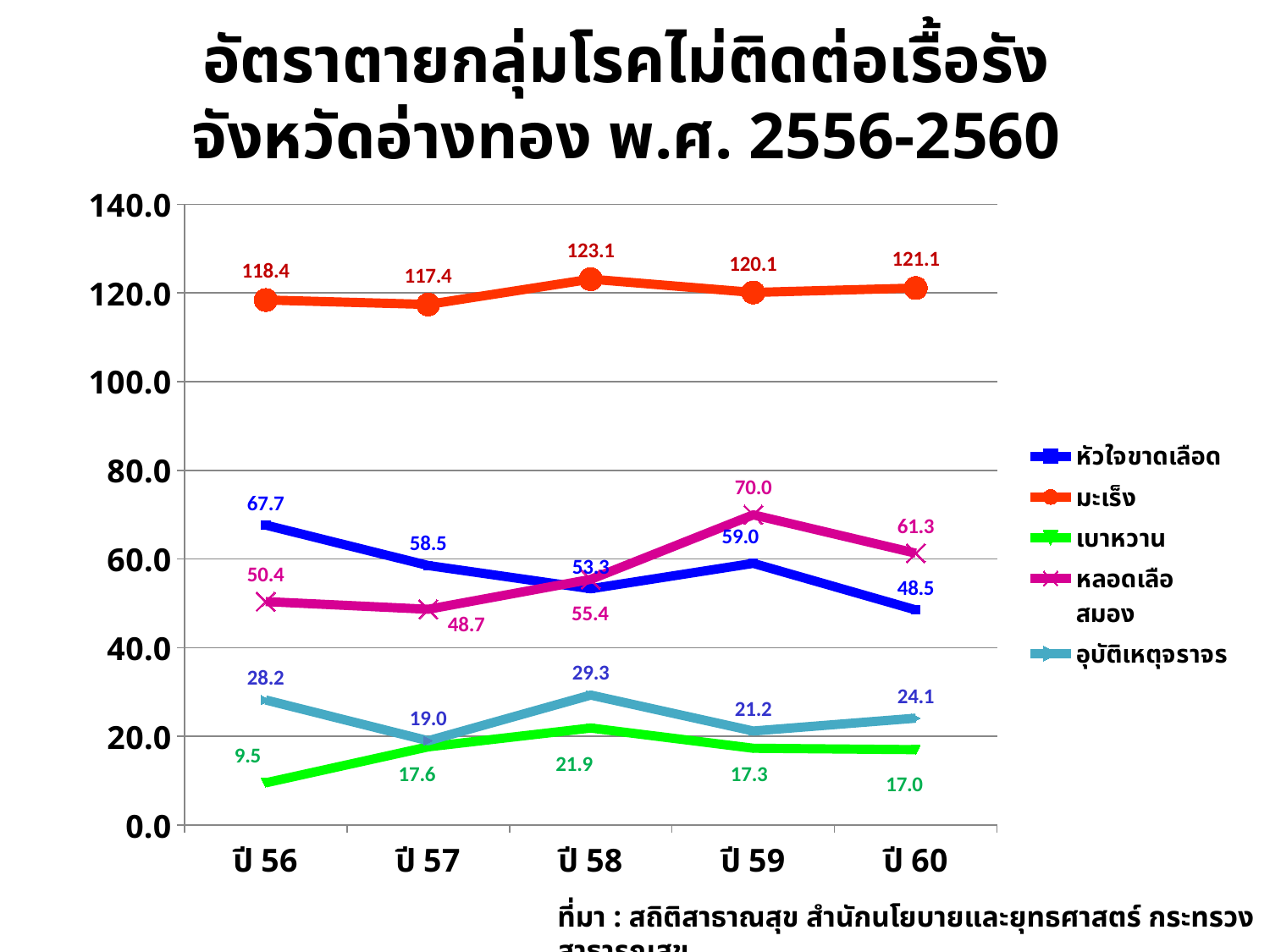
Which series has the lowest value in ปี 56? เบาหวาน What is the value for หลอดเลือดสมอง in ปี 59? 70.0 What is the value for เบาหวาน in ปี 56? 9.5 What is the value for อุบัติเหตุจราจร in ปี 60? 24.1 How many series does the legend list? 5 What is the difference between the หัวใจขาดเลือด values in ปี 56 and ปี 60? 19.2 What is the value for มะเร็ง in ปี 58? 123.1 Does the value for หัวใจขาดเลือด rise or fall from ปี 56 to ปี 58? fall In ปี 59, which is larger: หลอดเลือดสมอง or หัวใจขาดเลือด? หลอดเลือดสมอง Which series has the highest value in ปี 60? มะเร็ง What type of chart is shown on the slide? line chart How many years are shown on the x axis? 5